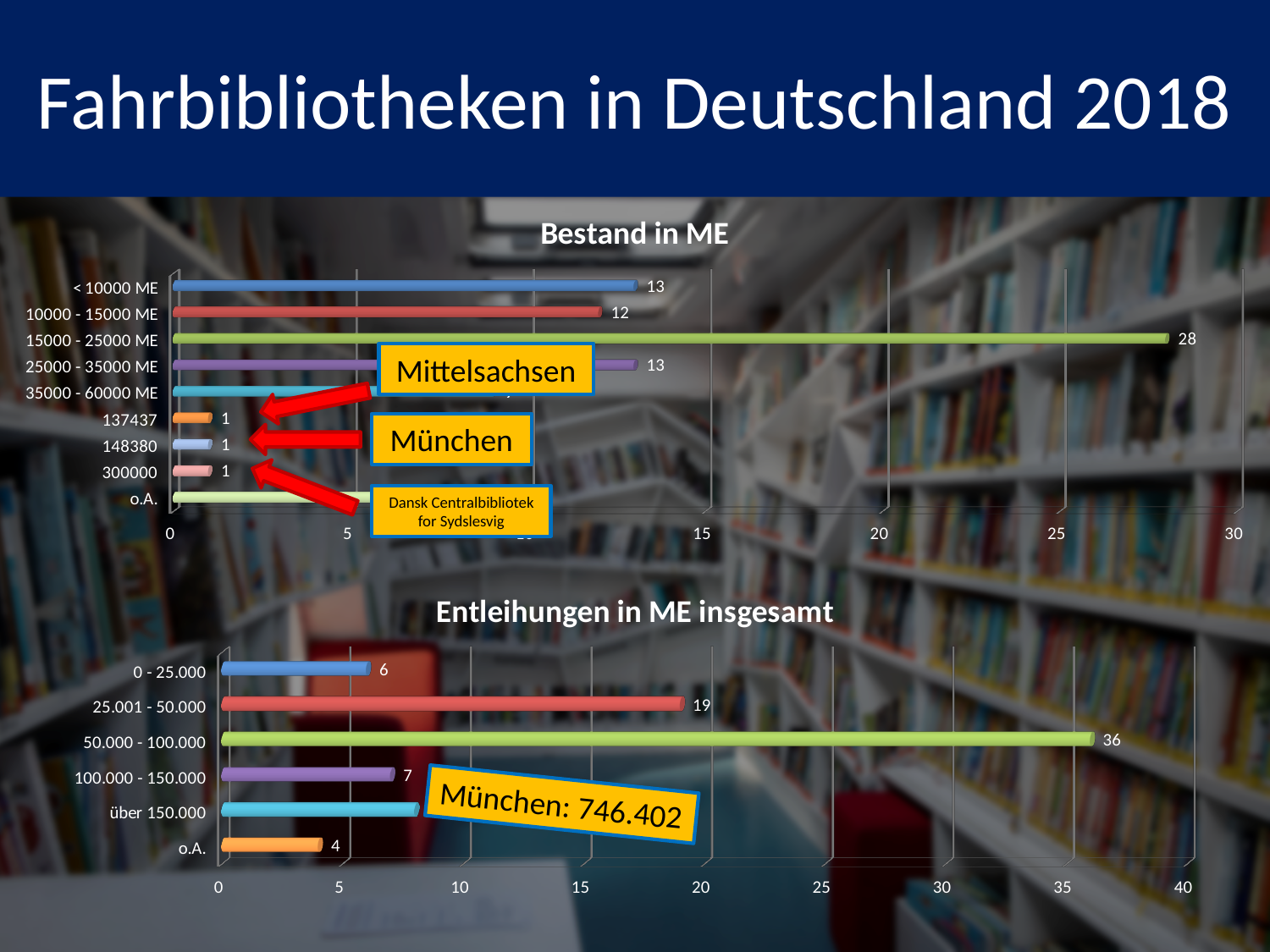
In the 'Bestand in ME' chart, how many categories are shown on the vertical axis? 9 In the 'Entleihungen in ME insgesamt' chart, what is the difference between the values for 50.000 - 100.000 and 25.001 - 50.000? 17 In the 'Entleihungen in ME insgesamt' chart, what is the value for 25.001 - 50.000? 19 In the 'Entleihungen in ME insgesamt' chart, which category has the lowest value? o.A. In the 'Bestand in ME' chart, which is larger: the value for < 10000 ME or for 10000 - 15000 ME? < 10000 ME In the 'Entleihungen in ME insgesamt' chart, which category has the highest value? 50.000 - 100.000 In the 'Bestand in ME' chart, which category has the highest value? 15000 - 25000 ME What type of chart is the 'Bestand in ME' chart? Bar chart In the 'Entleihungen in ME insgesamt' chart, is the value for über 150.000 greater or less than 10? less In the 'Bestand in ME' chart, what is the difference between the values for 15000 - 25000 ME and 10000 - 15000 ME? 16 In the 'Bestand in ME' chart, what is the value for 10000 - 15000 ME? 12 In the 'Bestand in ME' chart, what is the value for 15000 - 25000 ME? 28